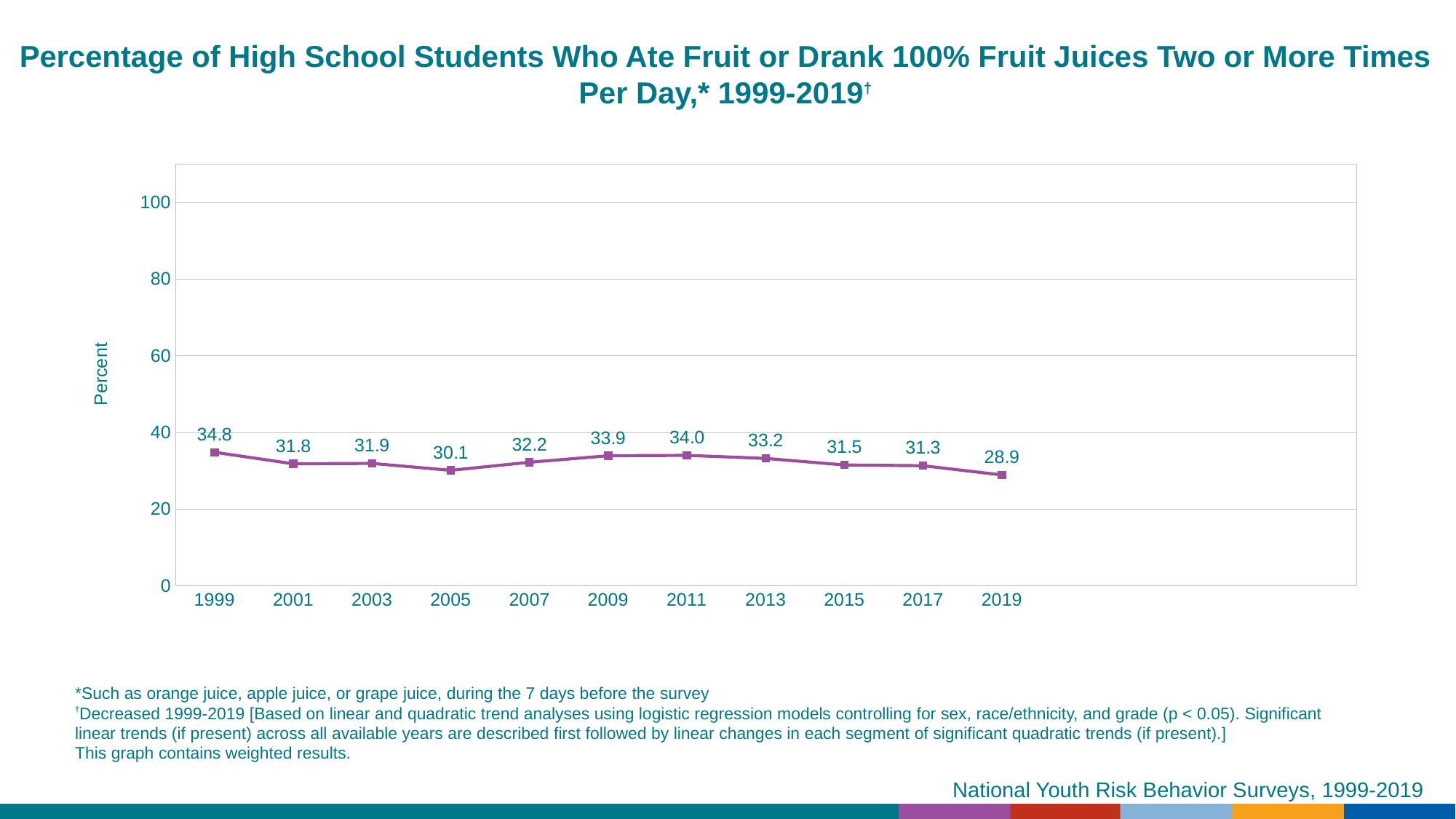
Which year has the lowest value on the chart? 2019 Which year has the highest value on the chart? 1999 What is the value shown for 2019? 28.9 What is the label on the vertical axis? Percent What kind of chart is shown on the slide? line chart What percentage of high school students ate fruit or drank 100% fruit juices two or more times per day in 1999? 34.8 Is the value for 2013 greater or less than 40? less How many years are plotted on the chart? 11 What is the difference between the values for 2011 and 2005? 3.9 Which year has a larger value, 2009 or 2015? 2009 What is the value shown for 2005? 30.1 What is the difference between the values for 1999 and 2019? 5.9